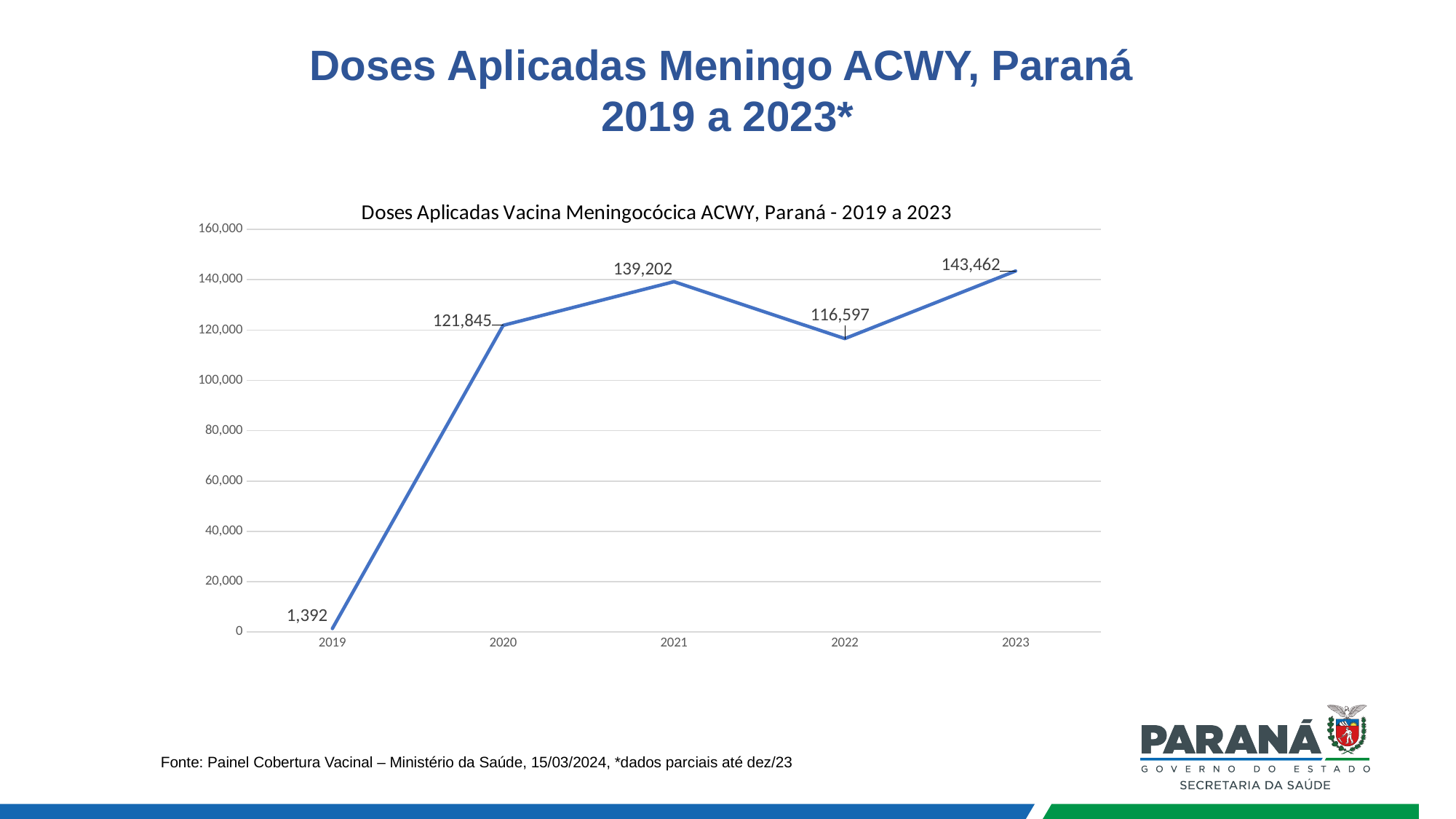
What is the difference between the values for 2023 and 2022? 26,865 Which year has the lowest value? 2019 What is the chart's title? Doses Aplicadas Vacina Meningocócica ACWY, Paraná - 2019 a 2023 What kind of chart is shown? line chart Is the value for 2020 greater or less than 100,000? greater How many years are plotted on the chart? 5 Which year has the highest value? 2023 What is the difference between the values for 2020 and 2019? 120,453 What is the value for 2022? 116,597 What is the value for 2019? 1,392 What is the value for 2021? 139,202 Which is larger, the value for 2021 or the value for 2022? 2021